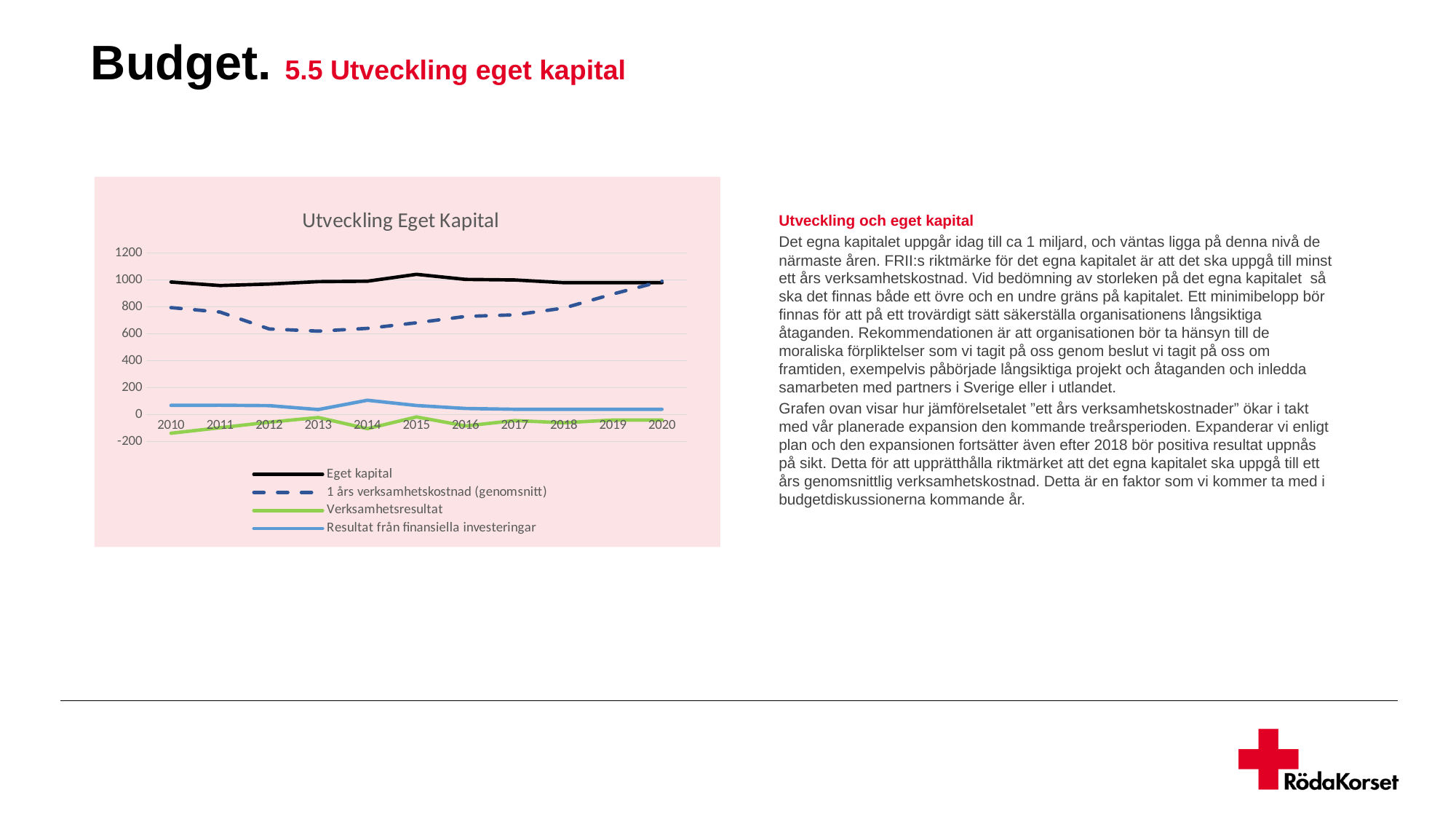
In which year does Resultat från finansiella investeringar reach its highest value? 2014 Which series is drawn with a dashed line in the chart? 1 års verksamhetskostnad (genomsnitt) Is the value of Verksamhetsresultat in 2010 greater or less than 0? less What is the title of the chart? Utveckling Eget Kapital How many series does the chart's legend list? 4 In which year is 1 års verksamhetskostnad (genomsnitt) at its highest? 2020 Is the value of 1 års verksamhetskostnad (genomsnitt) in 2013 greater or less than 800? less What kind of chart is shown on the slide? line chart How many years are shown along the x axis of the chart? 11 Is the value of Eget kapital in 2010 greater or less than 800? greater In 2013, which is larger: Eget kapital or 1 års verksamhetskostnad (genomsnitt)? Eget kapital In which year is Verksamhetsresultat at its lowest? 2010